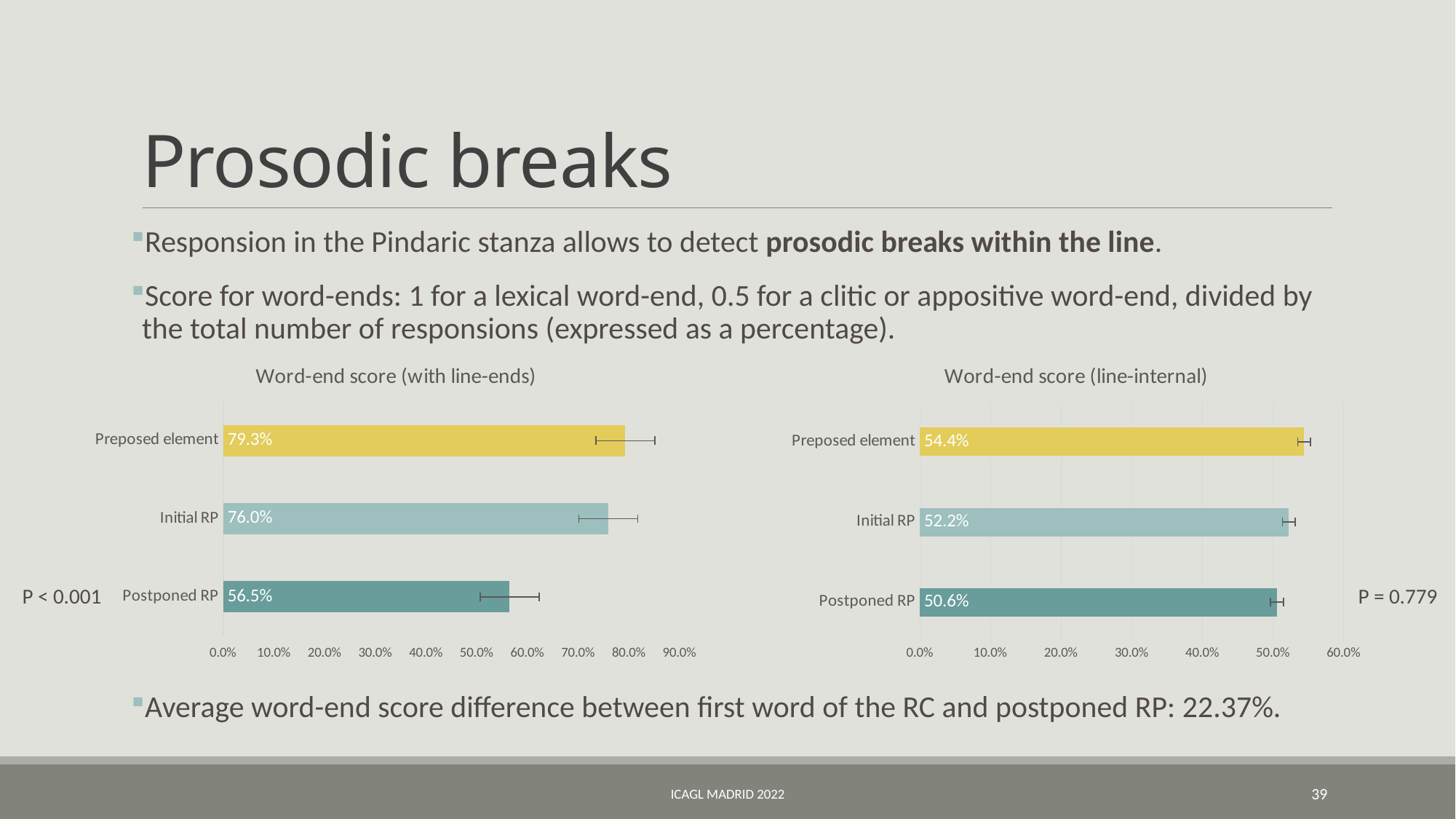
In the 'Word-end score (with line-ends)' chart, which category has the highest value? Preposed element What kind of chart is the 'Word-end score (with line-ends)' chart? Bar chart In the 'Word-end score (with line-ends)' chart, which is larger: the value for Initial RP or the value for Postponed RP? Initial RP What P value is shown next to the 'Word-end score (line-internal)' chart? P = 0.779 In the 'Word-end score (with line-ends)' chart, what is the difference between the Preposed element and Postponed RP values? 22.8% How many categories are shown in the 'Word-end score (line-internal)' chart? 3 In the 'Word-end score (with line-ends)' chart, what is the value for Postponed RP? 56.5% In the 'Word-end score (line-internal)' chart, what is the value for Postponed RP? 50.6% In the 'Word-end score (line-internal)' chart, what is the value for Initial RP? 52.2% In the 'Word-end score (line-internal)' chart, what is the difference between the Preposed element and Initial RP values? 2.2% In the 'Word-end score (with line-ends)' chart, what is the value for Preposed element? 79.3% In the 'Word-end score (line-internal)' chart, which category has the lowest value? Postponed RP